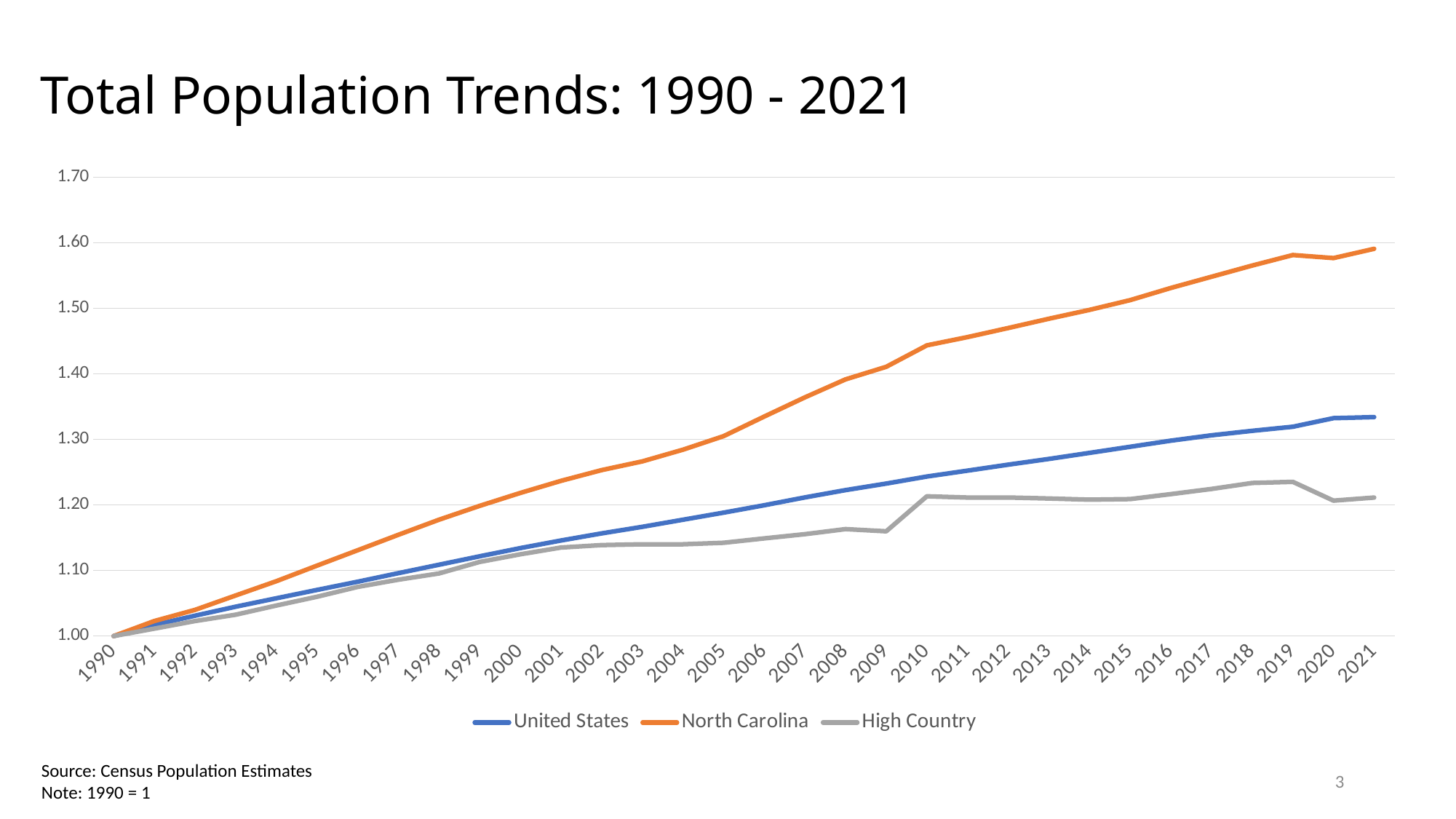
Is the value for North Carolina in 2021 greater or less than 1.50? greater Does the North Carolina line generally rise or fall from 1990 to 2021? rise Is the value for High Country in 2021 greater or less than 1.30? less What kind of chart is shown on the slide? line chart How many years are plotted along the x axis? 32 Which series has the highest value in 2021? North Carolina Which series has the lowest value in 2021? High Country What colour is the North Carolina line in the legend? orange Is the value for North Carolina in 2010 greater or less than 1.40? greater What is the value for North Carolina in 1990? 1.00 How many series does the legend list? 3 In 2021, which is larger, the value for United States or the value for High Country? United States